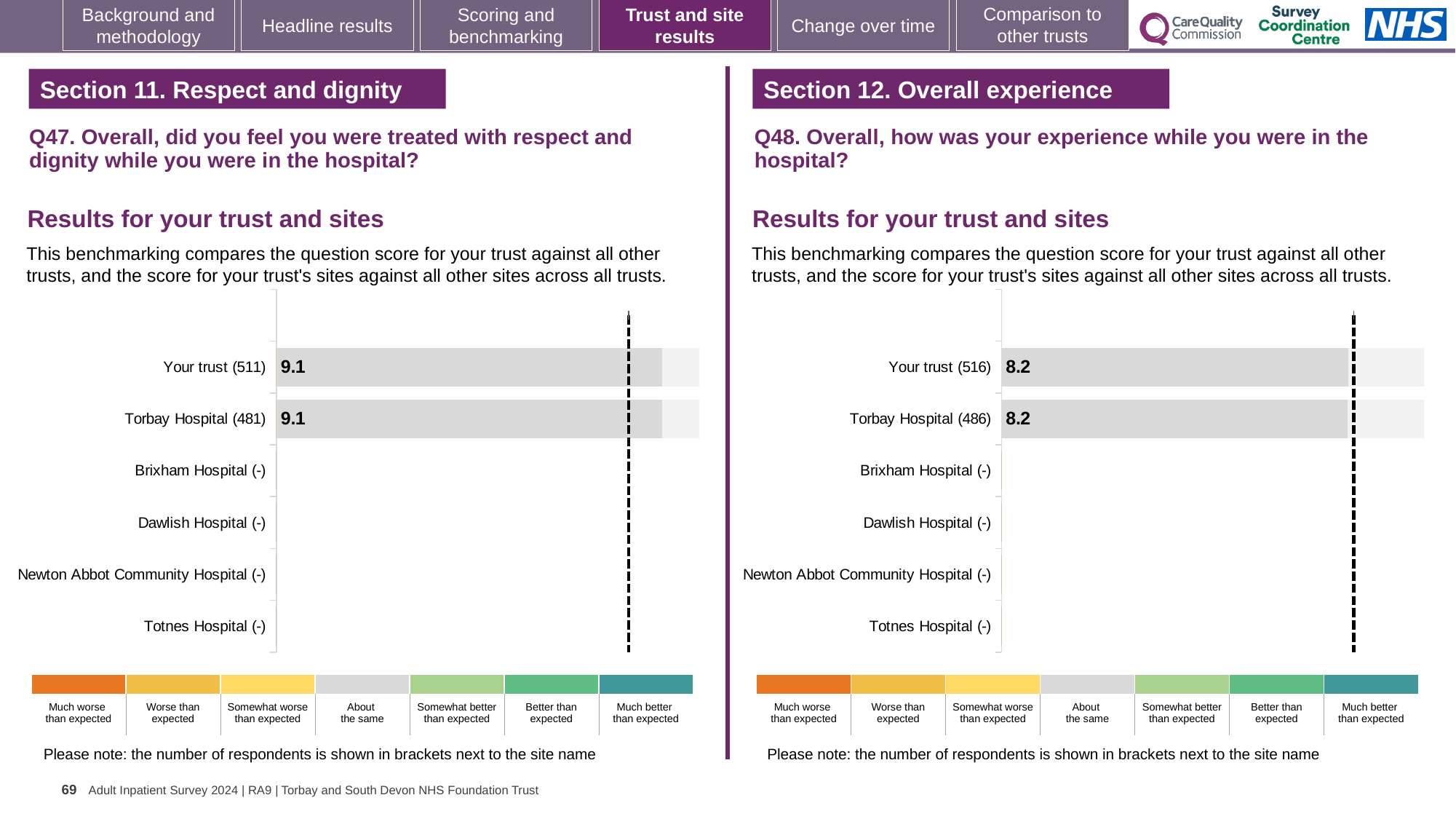
How many site/trust categories are listed on the vertical axis of the Q48 chart on the right? 6 Is the score for Your trust in the Q47 chart on the left larger or smaller than the score for Your trust in the Q48 chart on the right? larger In the Q48 chart on the right, how many respondents are shown in brackets for Torbay Hospital? 486 What kind of chart is used for the Q47 results on the left? bar chart In the Q48 chart on the right, what is the score for Torbay Hospital? 8.2 In the Q47 chart on the left, what is the score for Your trust? 9.1 In the Q48 chart on the right, what is the score for Your trust? 8.2 In the Q47 chart on the left, what is the difference between the score for Your trust and the score for Torbay Hospital? 0 How many benchmark categories does the colour legend below the Q48 chart on the right list? 7 In the Q47 chart on the left, what is the score for Torbay Hospital? 9.1 In the Q47 chart on the left, how many sites show no score (marked with a dash)? 4 In the Q47 chart on the left, how many respondents are shown in brackets for Your trust? 511